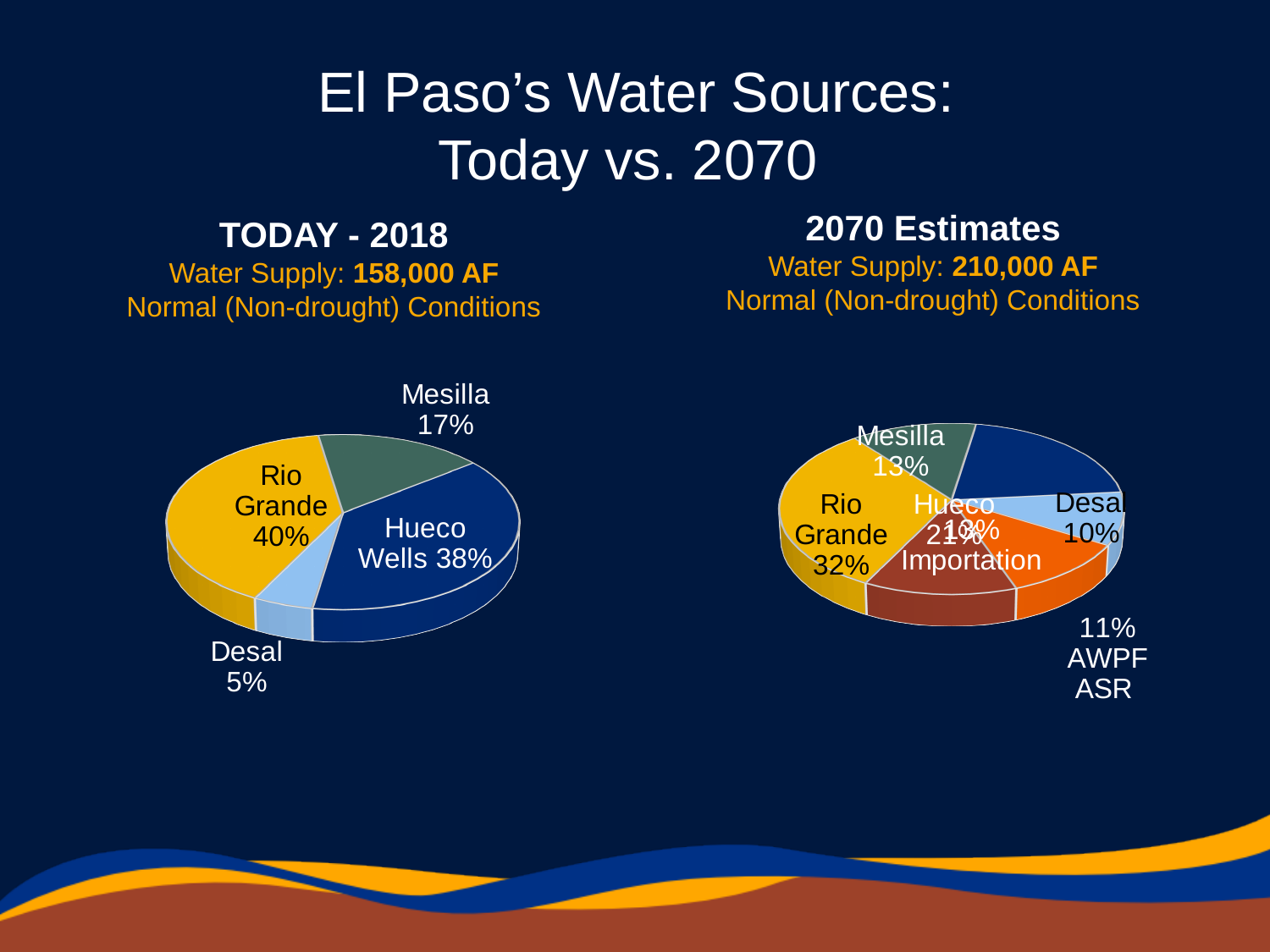
In the TODAY - 2018 pie chart, what percentage is shown for Mesilla? 17% In the TODAY - 2018 pie chart, which source has the largest share? Rio Grande How many slices does the TODAY - 2018 pie chart have? 4 In the 2070 Estimates pie chart, what share is labelled for AWPF ASR? 11% In the TODAY - 2018 pie chart, what share of the water supply comes from the Rio Grande? 40% By how many percentage points does the Rio Grande share in the TODAY - 2018 chart exceed its share in the 2070 Estimates chart? 8 percentage points In the TODAY - 2018 pie chart, what share does Desal represent? 5% What type of chart is used on this slide to show El Paso's water sources? Pie chart In the 2070 Estimates pie chart, what percentage is labelled for Desal? 10% In the TODAY - 2018 pie chart, what percentage is labelled for Hueco Wells? 38% In the TODAY - 2018 pie chart, which source has the smallest share? Desal In the 2070 Estimates pie chart, what share is shown for the Rio Grande? 32%